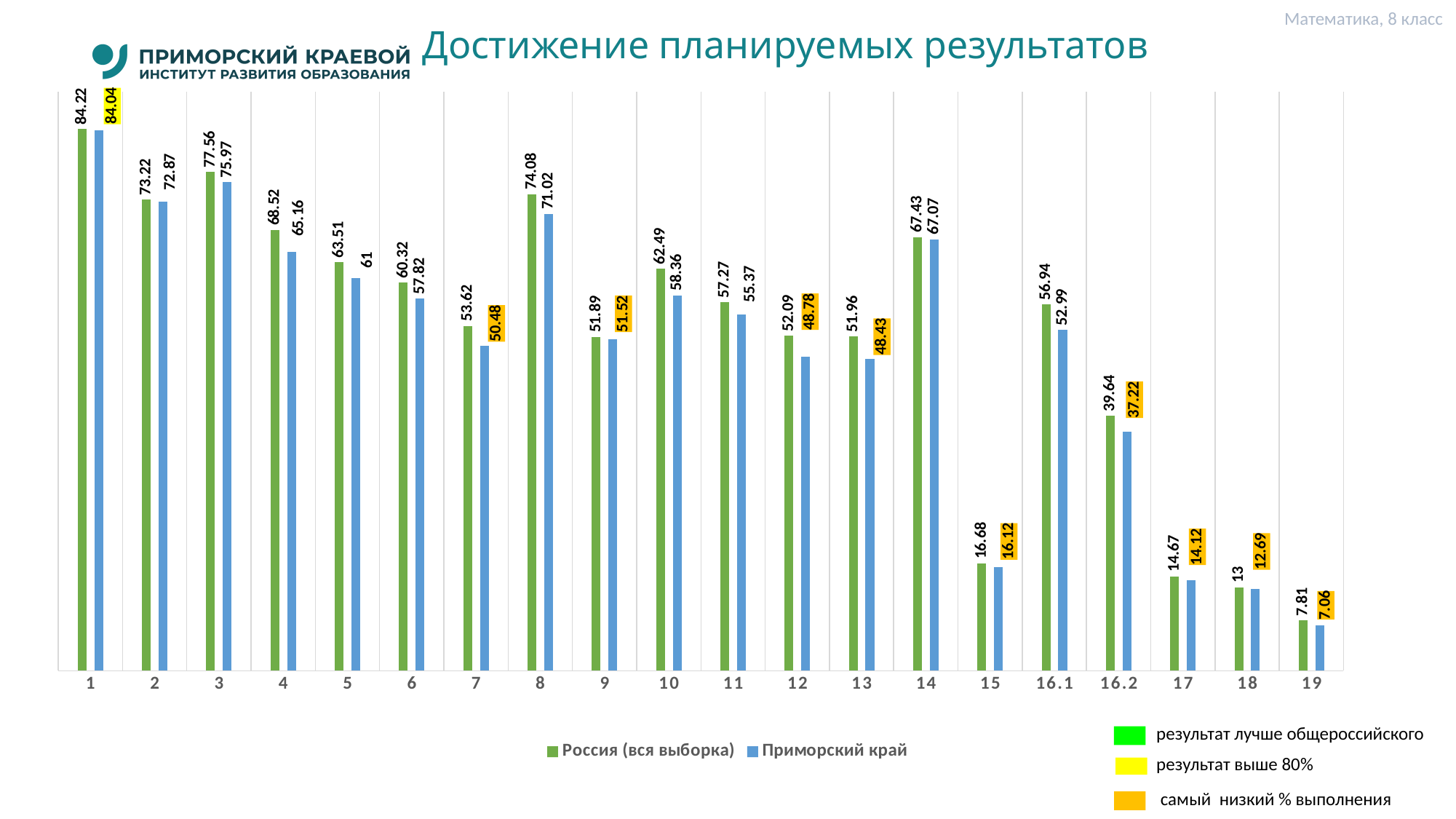
What is the value for Приморский край for task 16.2? 37.22 What is the difference between the Россия (вся выборка) and Приморский край values for task 16.1? 3.95 What is the value for Россия (вся выборка) for task 8? 74.08 Which task has the lowest value for Россия (вся выборка)? 19 What kind of chart is shown on the slide? bar chart Which is larger for task 10: the value for Россия (вся выборка) or for Приморский край? Россия (вся выборка) Which task has the highest value for Приморский край? 1 How many task categories are shown on the x axis? 20 What is the value for Приморский край for task 4? 65.16 How many series does the chart legend list? 2 Which colour represents Приморский край in the chart? blue What is the title of the chart on the slide? Достижение планируемых результатов